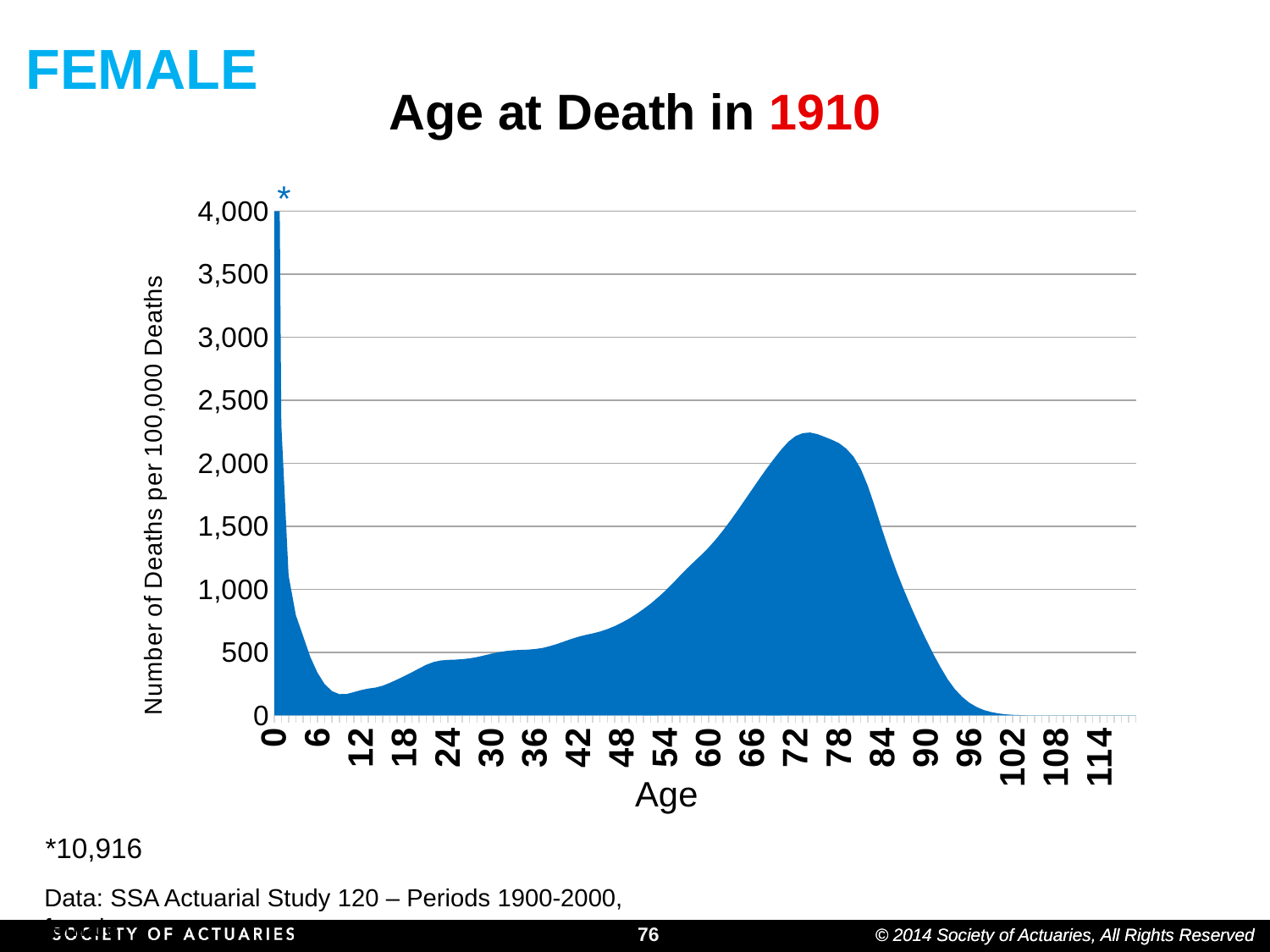
Do the values rise or fall as age increases from 48 to 72? rise Do the values rise or fall as age increases from 78 to 96? fall Is the value at age 60 greater or less than 1,000? greater At which age is the number of deaths per 100,000 deaths highest? 0 What is the number of deaths per 100,000 deaths at age 0, as given by the asterisk footnote? 10,916 What is the title of the chart? Age at Death in 1910 Is the value at age 12 greater or less than 500? less Is the value at age 72 greater or less than 2,000? greater What is the label of the vertical axis? Number of Deaths per 100,000 Deaths What kind of chart is shown on the slide? area chart Which age has the larger number of deaths per 100,000 deaths, age 48 or age 72? 72